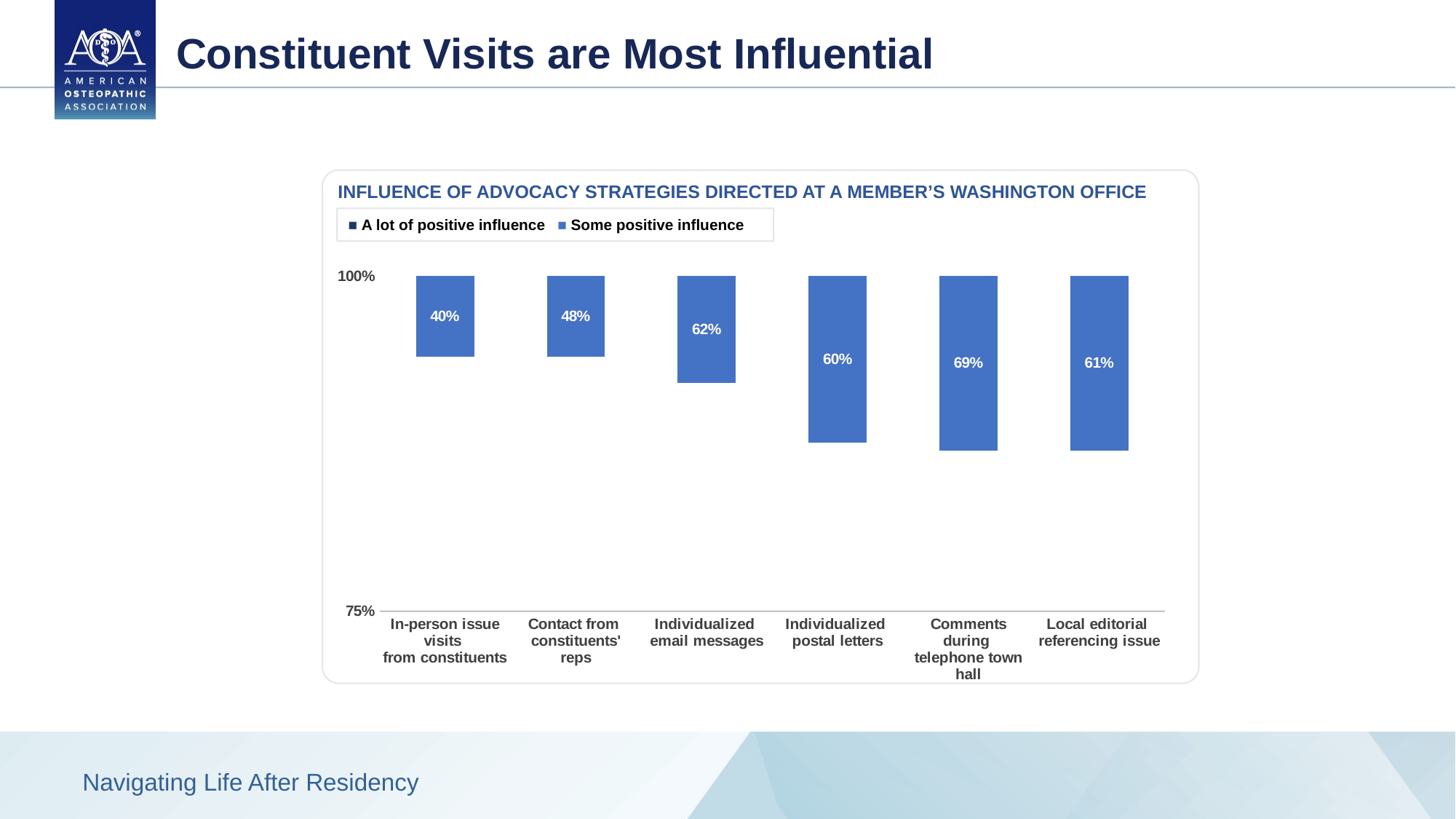
What is the title of the chart? INFLUENCE OF ADVOCACY STRATEGIES DIRECTED AT A MEMBER'S WASHINGTON OFFICE What data label is shown on the bar for Local editorial referencing issue? 61% What data label is shown on the bar for Contact from constituents' reps? 48% Which category has the lowest data label shown on its bar? In-person issue visits from constituents Which has the larger data label: Individualized email messages or Individualized postal letters? Individualized email messages What data label is shown on the bar for In-person issue visits from constituents? 40% Which category has the highest data label shown on its bar? Comments during telephone town hall How many series does the chart legend list? 2 What data label is shown on the bar for Individualized email messages? 62% How many categories are shown on the x axis of the chart? 6 What data label is shown on the bar for Comments during telephone town hall? 69% What is the difference between the data labels for Comments during telephone town hall and In-person issue visits from constituents? 29 percentage points